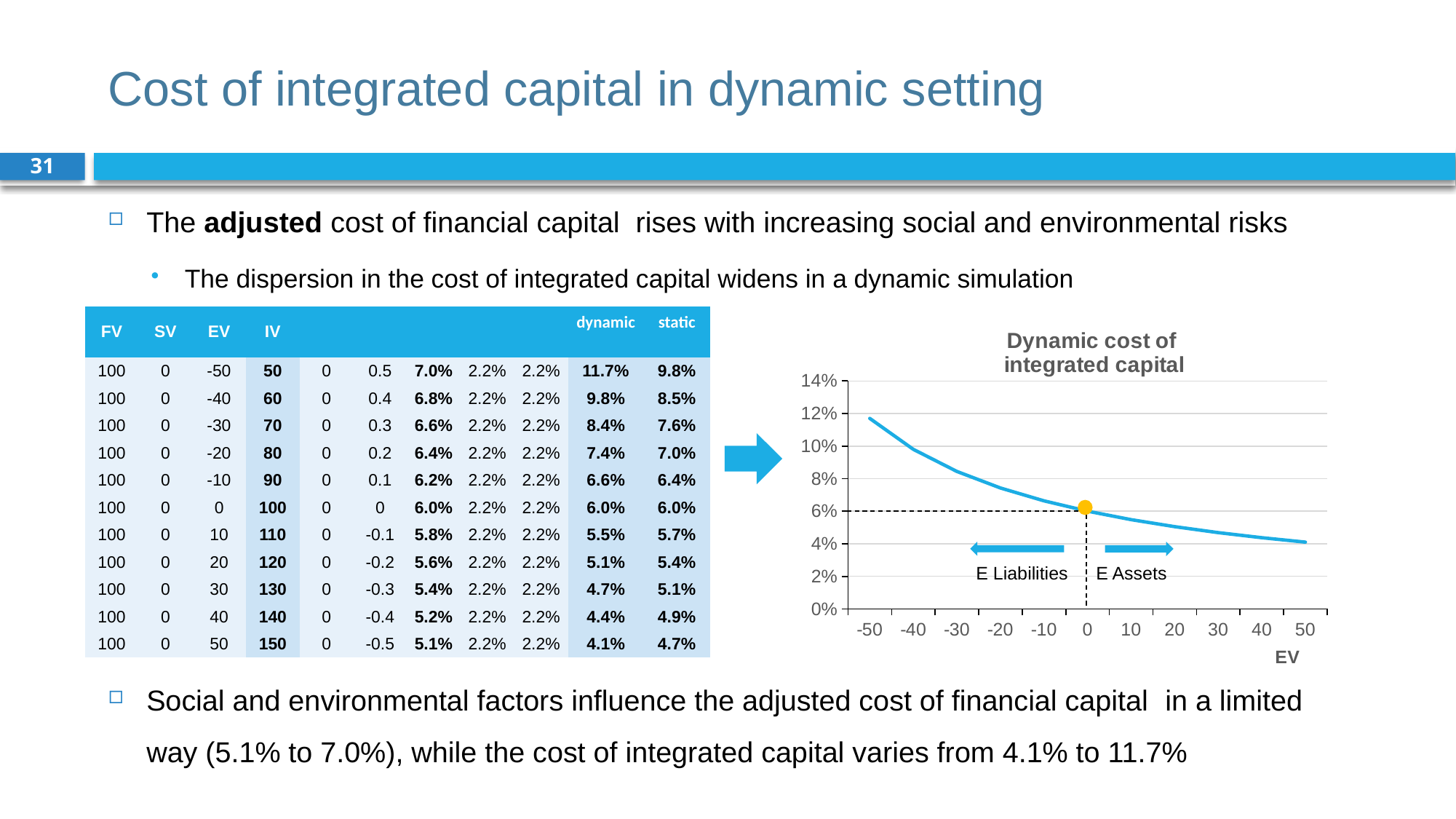
How many EV tick values are shown on the x axis of the 'Dynamic cost of integrated capital' chart? 11 In the 'Dynamic cost of integrated capital' chart, is the value at EV = 50 greater or less than 6%? less In the 'Dynamic cost of integrated capital' chart, at which EV value is the cost lowest? 50 In the 'Dynamic cost of integrated capital' chart, what value does the highlighted point at EV = 0 correspond to on the y axis? 6% In the 'Dynamic cost of integrated capital' chart, is the value at EV = -40 greater or less than 8%? greater In the 'Dynamic cost of integrated capital' chart, at which EV value is the cost highest? -50 What kind of chart is the 'Dynamic cost of integrated capital' chart? line chart In the 'Dynamic cost of integrated capital' chart, does the cost rise or fall as EV increases from -50 to 50? fall What are the two labels shown next to the arrows below the line in the 'Dynamic cost of integrated capital' chart? E Liabilities and E Assets In the 'Dynamic cost of integrated capital' chart, is the value at EV = 30 greater or less than 6%? less In the 'Dynamic cost of integrated capital' chart, which has the larger value: EV = -20 or EV = 20? EV = -20